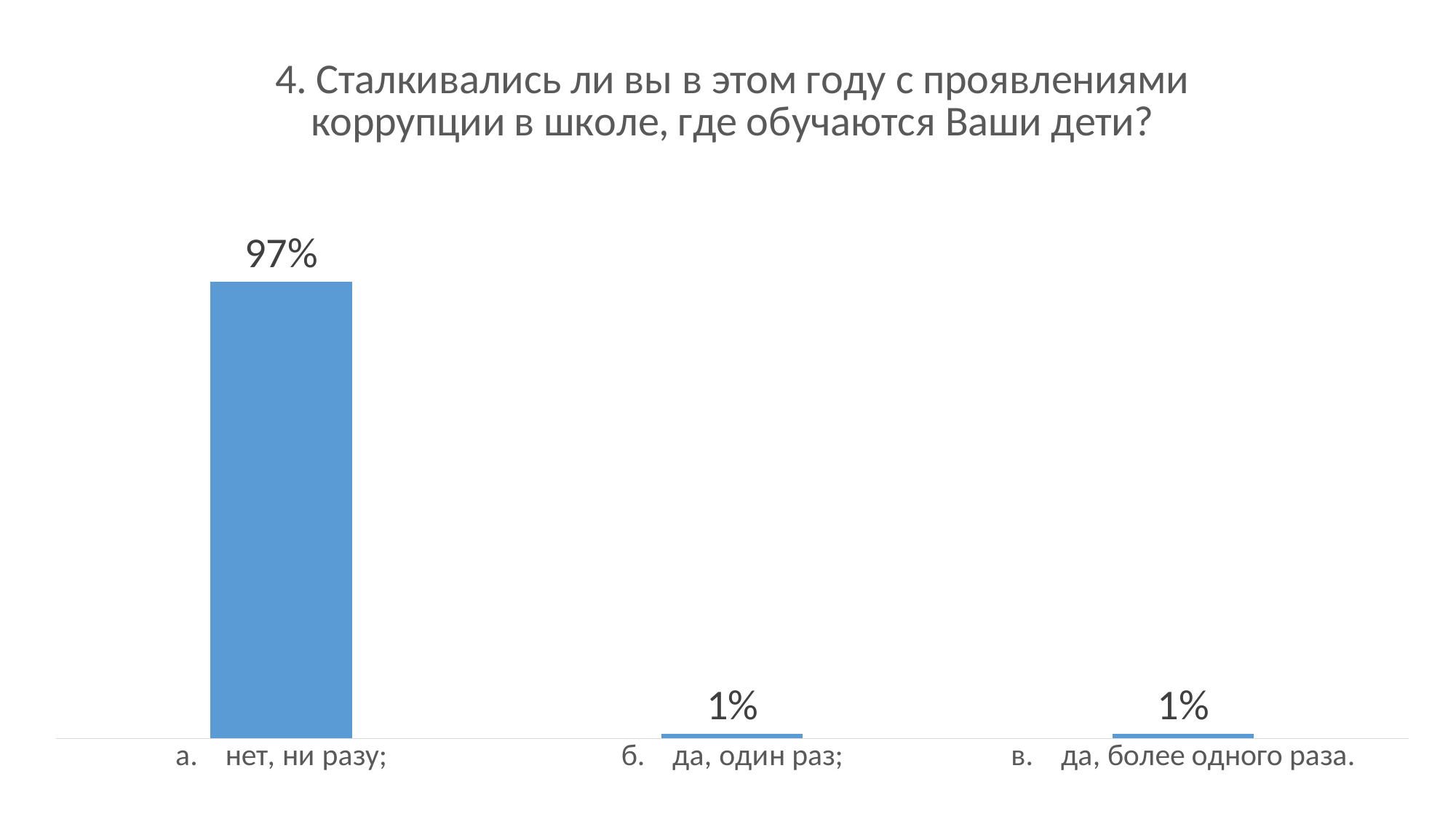
How many categories are shown in the chart? 3 What colour are the bars in the chart? blue What kind of chart is shown on the slide? bar chart What is the total of the three values shown in the chart? 99% What is the value for "а. нет, ни разу;"? 97% What is the value for "в. да, более одного раза."? 1% Which is larger, the value for "а. нет, ни разу;" or the value for "в. да, более одного раза."? а. нет, ни разу; Which category has the highest value? а. нет, ни разу; What is the difference between the values for "а. нет, ни разу;" and "б. да, один раз;"? 96% What is the title of the chart? 4. Сталкивались ли вы в этом году с проявлениями коррупции в школе, где обучаются Ваши дети? What is the value for "б. да, один раз;"? 1%